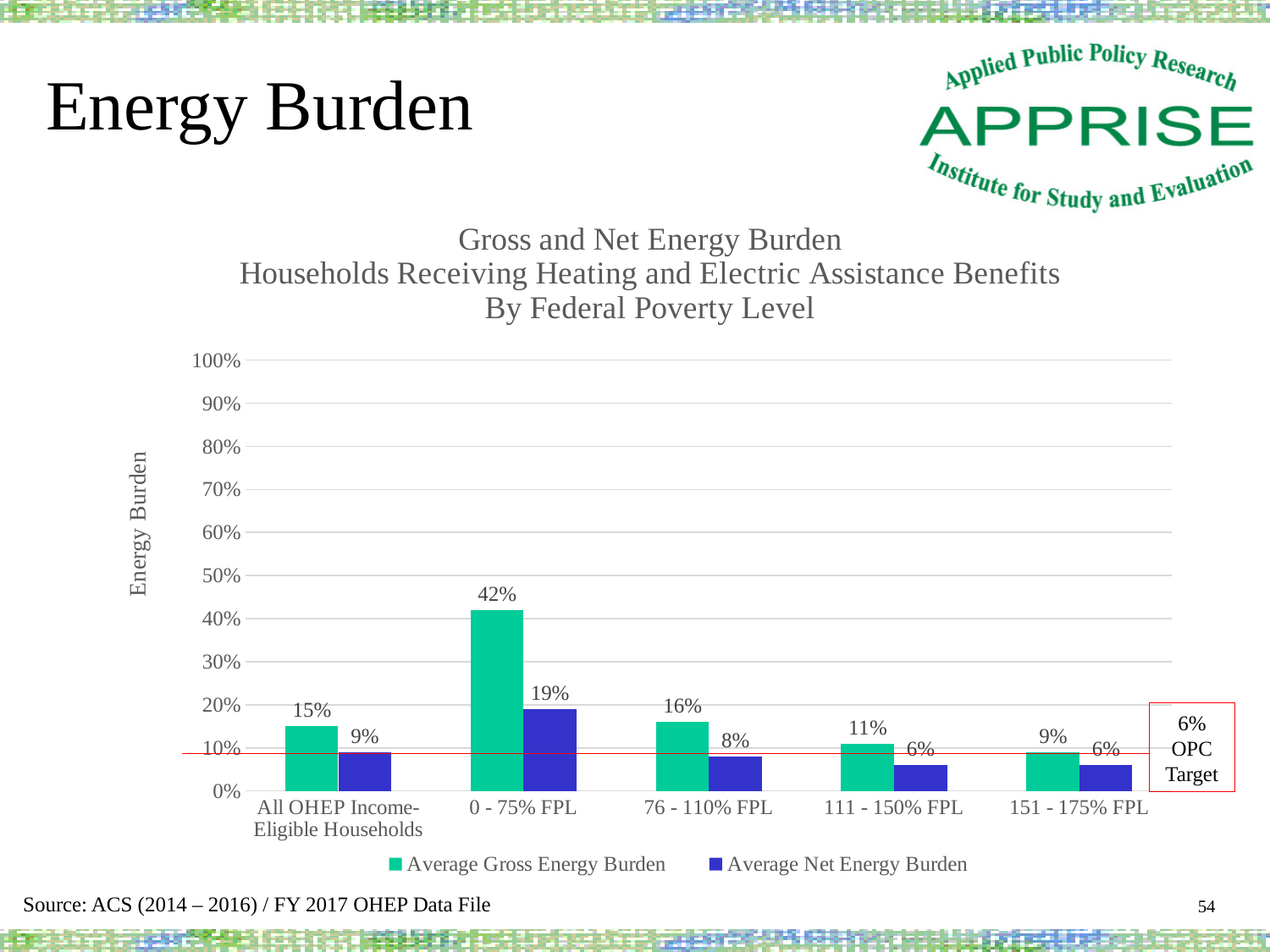
What kind of chart is shown on the slide? Bar chart Which category has the highest Average Gross Energy Burden? 0 - 75% FPL Which is larger, the Average Gross Energy Burden for All OHEP Income-Eligible Households or for 111 - 150% FPL? All OHEP Income-Eligible Households How many categories are shown on the x axis? 5 What is the OPC Target value marked by the red line? 6% What is the Average Net Energy Burden for 76 - 110% FPL? 8% How many series does the legend list? 2 Which category has the lowest Average Gross Energy Burden? 151 - 175% FPL What is the Average Net Energy Burden for All OHEP Income-Eligible Households? 9% What is the Average Gross Energy Burden for 0 - 75% FPL? 42% What is the difference between the Average Gross and Average Net Energy Burden for 0 - 75% FPL? 23% What is the difference between the Average Gross Energy Burden for 76 - 110% FPL and 111 - 150% FPL? 5%